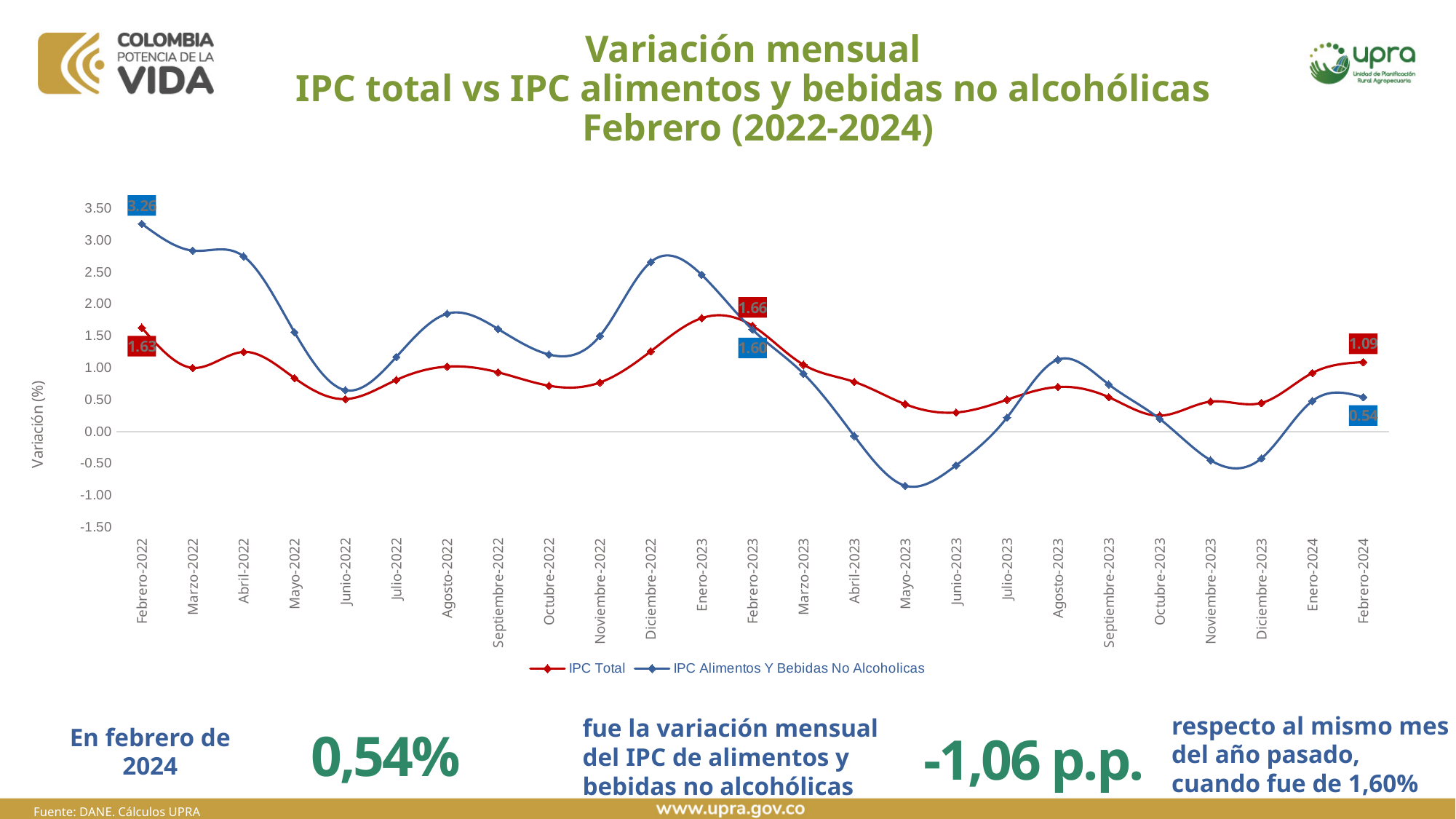
What type of chart is shown on the slide? line chart In which month does IPC Alimentos Y Bebidas No Alcoholicas reach its lowest value? Mayo-2023 Is the value of IPC Alimentos Y Bebidas No Alcoholicas in Mayo-2023 greater or less than -0.50? less How many series does the legend list? 2 In Febrero-2022, which series has the higher value, IPC Total or IPC Alimentos Y Bebidas No Alcoholicas? IPC Alimentos Y Bebidas No Alcoholicas What are the two series named in the legend? IPC Total; IPC Alimentos Y Bebidas No Alcoholicas What is the difference between IPC Total and IPC Alimentos Y Bebidas No Alcoholicas in Febrero-2024? 0.55 By how much did IPC Alimentos Y Bebidas No Alcoholicas change from Febrero-2023 to Febrero-2024? -1.06 What is the value of IPC Total in Febrero-2023? 1.66 What is the value of IPC Alimentos Y Bebidas No Alcoholicas in Febrero-2022? 3.26 What is the value of IPC Total in Febrero-2022? 1.63 What is the value of IPC Alimentos Y Bebidas No Alcoholicas in Febrero-2024? 0.54